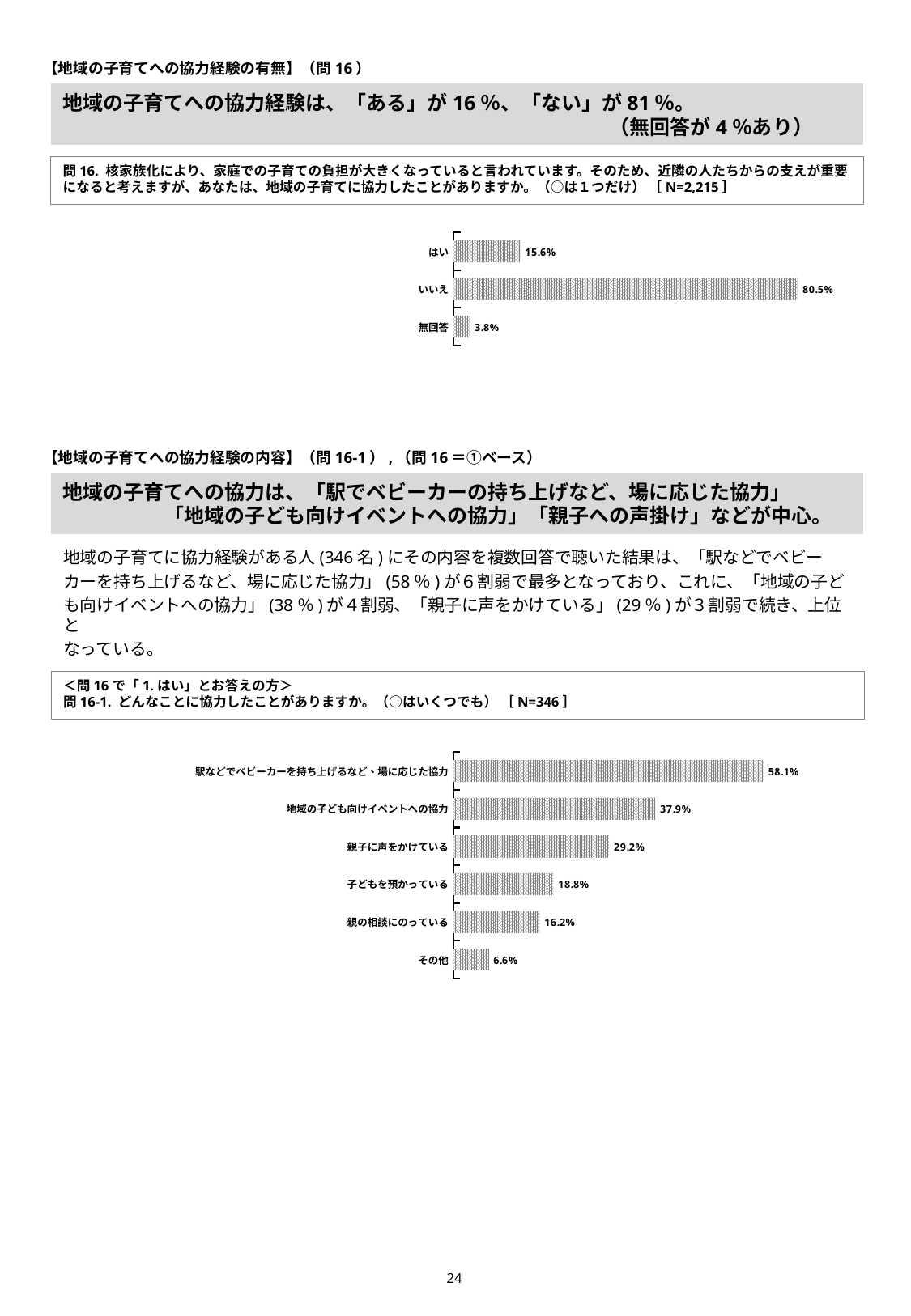
In the bottom chart (問16-1), which category has the highest value? 駅などでベビーカーを持ち上げるなど、場に応じた協力 In the top chart (問16), how many categories are shown? 3 In the bottom chart (問16-1), which is larger: 子どもを預かっている or 親の相談にのっている? 子どもを預かっている In the bottom chart (問16-1), what is the value for 親子に声をかけている? 29.2% In the top chart (問16), what is the value for いいえ? 80.5% In the top chart (問16), what is the difference between いいえ and はい? 64.9% In the bottom chart (問16-1), what is the difference between 地域の子ども向けイベントへの協力 and 親の相談にのっている? 21.7% What kind of chart is the bottom chart (問16-1)? Bar chart In the bottom chart (問16-1), which category has the lowest value? その他 In the top chart (問16), which category has the lowest value? 無回答 In the bottom chart (問16-1), what is the value for 子どもを預かっている? 18.8% In the top chart (問16), what is the value for はい? 15.6%